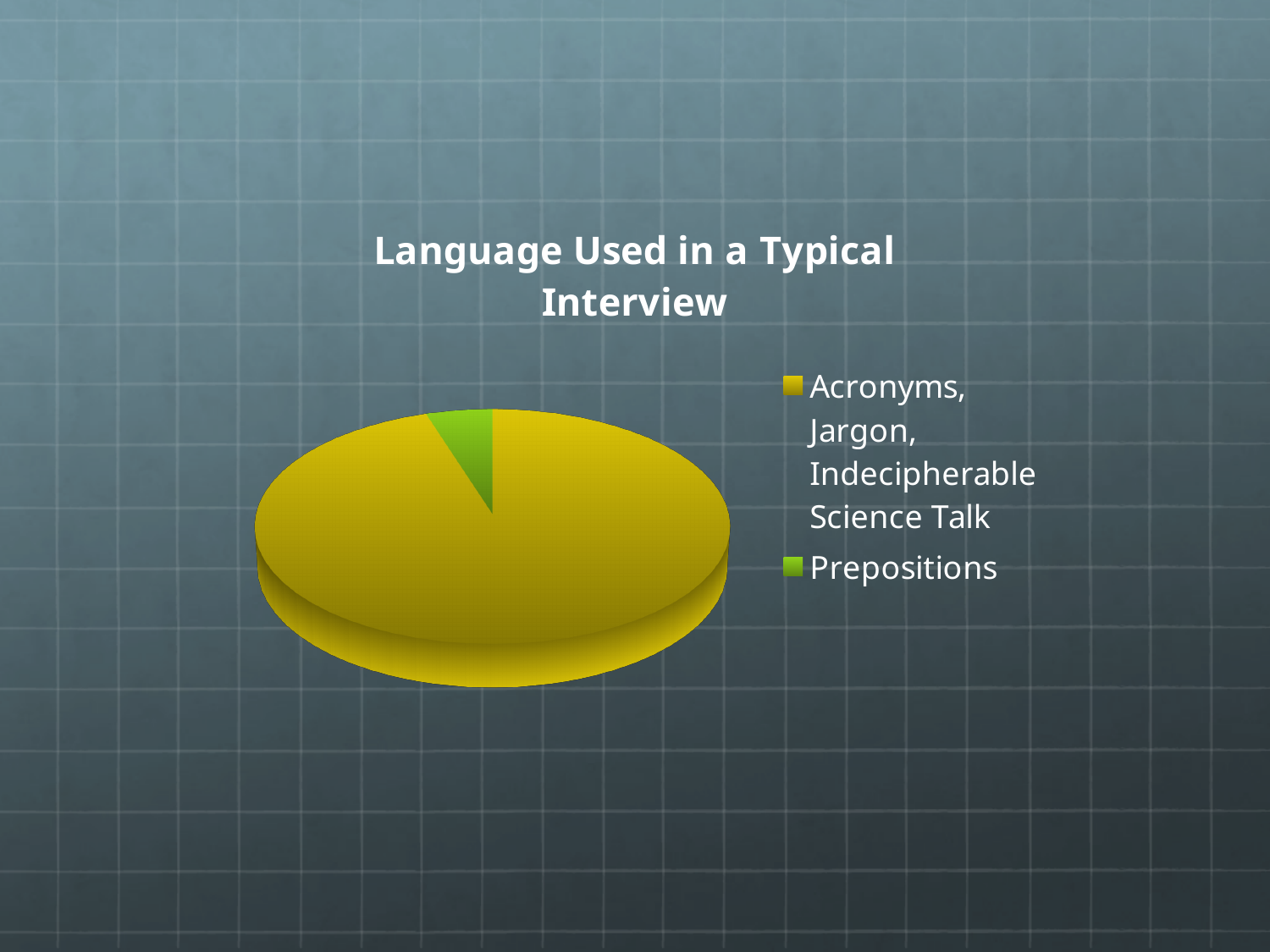
What kind of chart is shown on the slide? pie chart Which slice is larger, Acronyms, Jargon, Indecipherable Science Talk or Prepositions? Acronyms, Jargon, Indecipherable Science Talk What is the title of the chart? Language Used in a Typical Interview Which category has the smallest slice of the pie? Prepositions Which category has the largest slice of the pie? Acronyms, Jargon, Indecipherable Science Talk How many categories does the pie chart have? 2 What colour is the slice for Prepositions? green How many entries does the legend list? 2